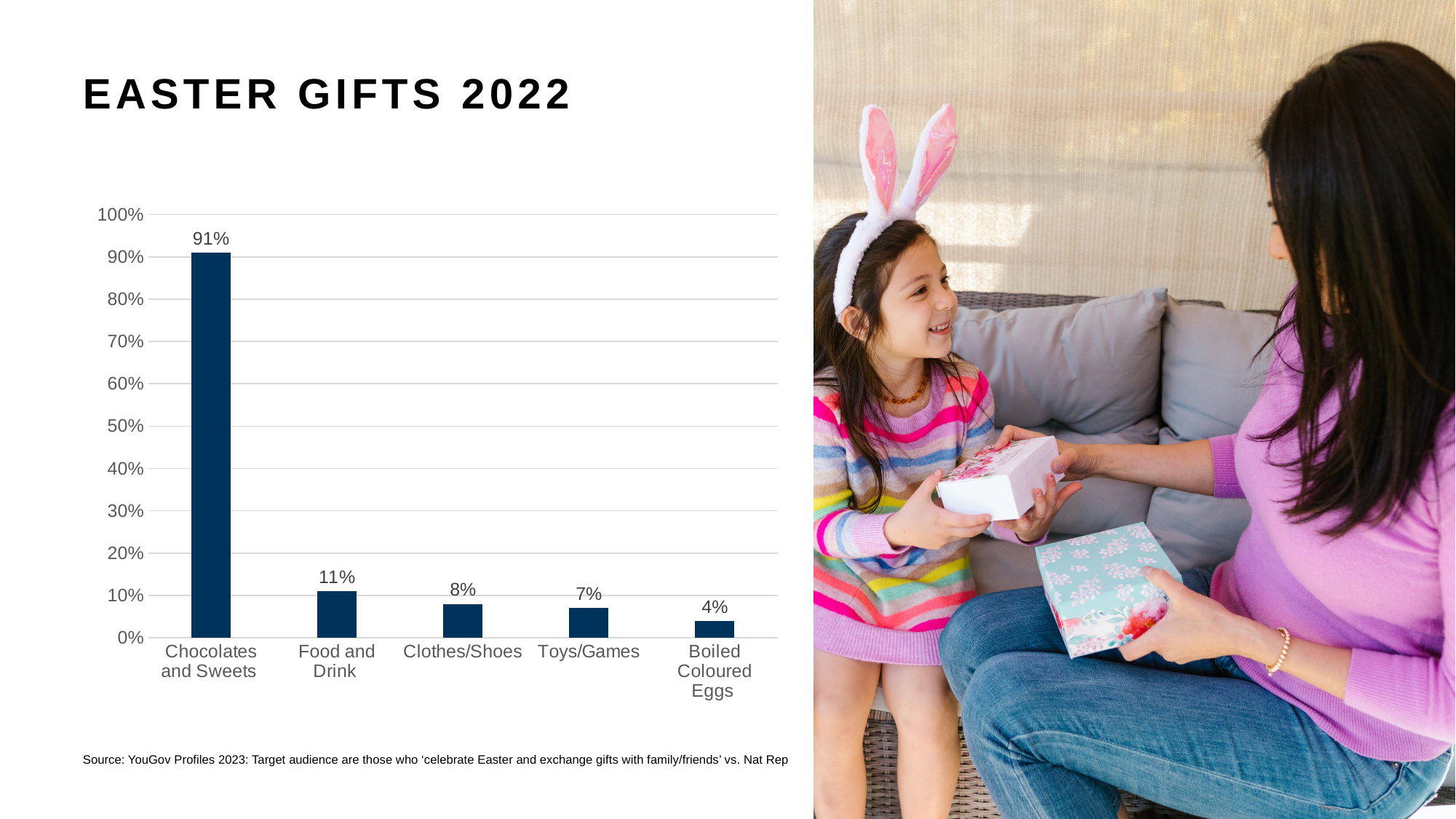
What is the title of the chart? EASTER GIFTS 2022 What is the value for Clothes/Shoes? 8% What is the value for Chocolates and Sweets? 91% What is the value for Food and Drink? 11% What kind of chart is shown on the slide? Bar chart Which is larger, the value for Clothes/Shoes or the value for Toys/Games? Clothes/Shoes Which category has the highest value? Chocolates and Sweets What is the value for Toys/Games? 7% Which category has the lowest value? Boiled Coloured Eggs What is the value for Boiled Coloured Eggs? 4% How many categories are shown on the chart? 5 What is the difference between the values for Chocolates and Sweets and Food and Drink? 80%